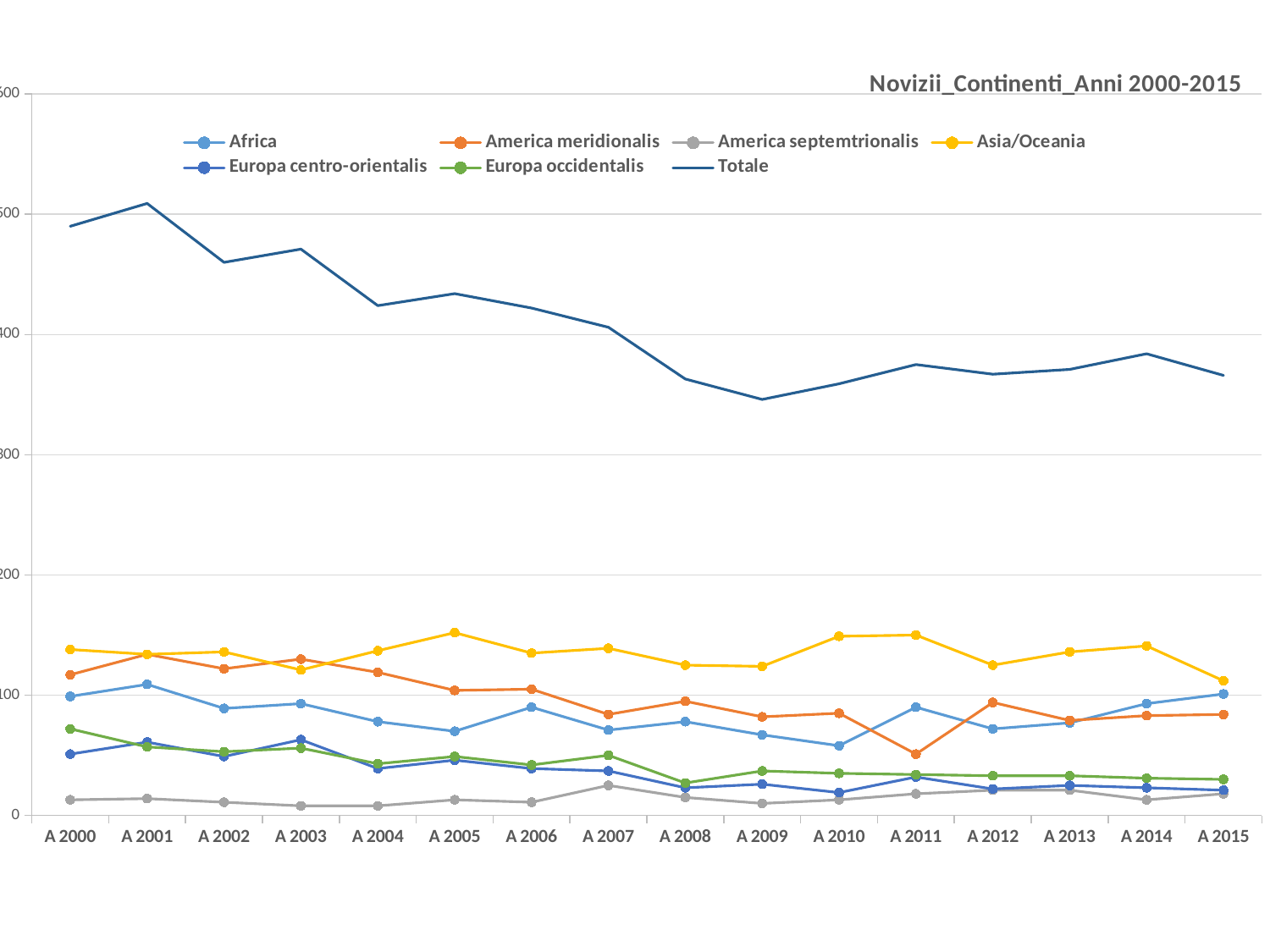
Which series has the lowest value at A 2003? America septemtrionalis What is the title of the chart? Novizii_Continenti_Anni 2000-2015 Is the value of Asia/Oceania for A 2005 greater or less than 100? greater Is the value of Totale for A 2009 greater or less than 400? less Is the value of America septemtrionalis for A 2003 greater or less than 100? less What kind of chart is shown on the slide? line chart Does the Totale line generally rise or fall from A 2000 to A 2015? fall Excluding Totale, which series has the highest value at A 2010? Asia/Oceania Which is larger at A 2005, the value for Asia/Oceania or the value for Africa? Asia/Oceania How many years are shown along the x axis? 16 How many series does the legend list? 7